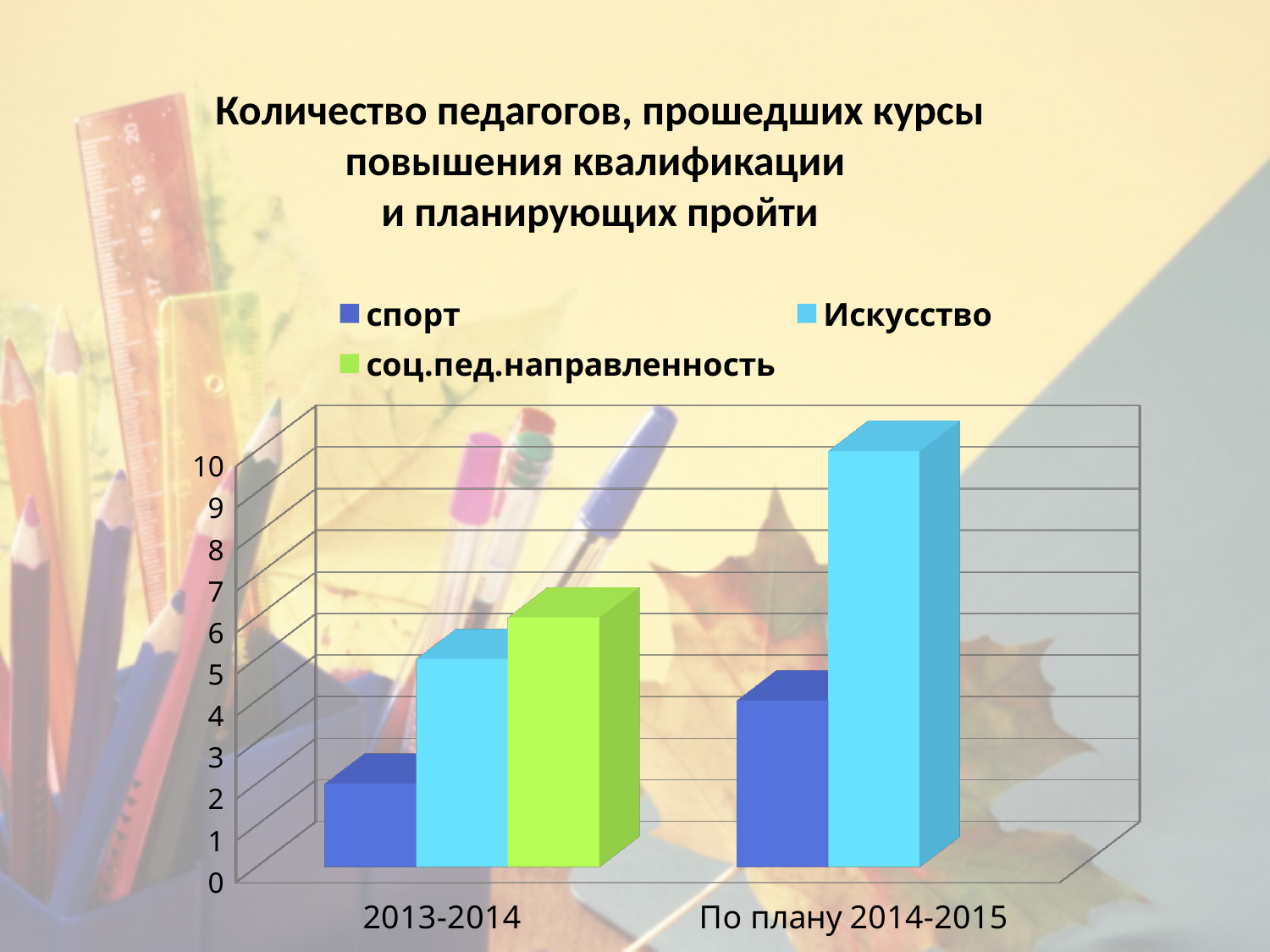
Is the value for Искусство in По плану 2014-2015 greater or less than 8? greater Is the value for спорт in 2013-2014 greater or less than 4? less Does the value for спорт rise or fall from 2013-2014 to По плану 2014-2015? rise How many series does the legend list? 3 How many categories are shown on the x axis? 2 Which is larger: the value for Искусство in 2013-2014 or in По плану 2014-2015? По плану 2014-2015 Which series has the lowest value in the 2013-2014 category? спорт What kind of chart is shown on the slide? bar chart What colour are the bars for the Искусство series? light blue Is the value for соц.пед.направленность in 2013-2014 greater or less than 4? greater Which series has the highest value in the 2013-2014 category? соц.пед.направленность Which series has the highest value in the По плану 2014-2015 category? Искусство